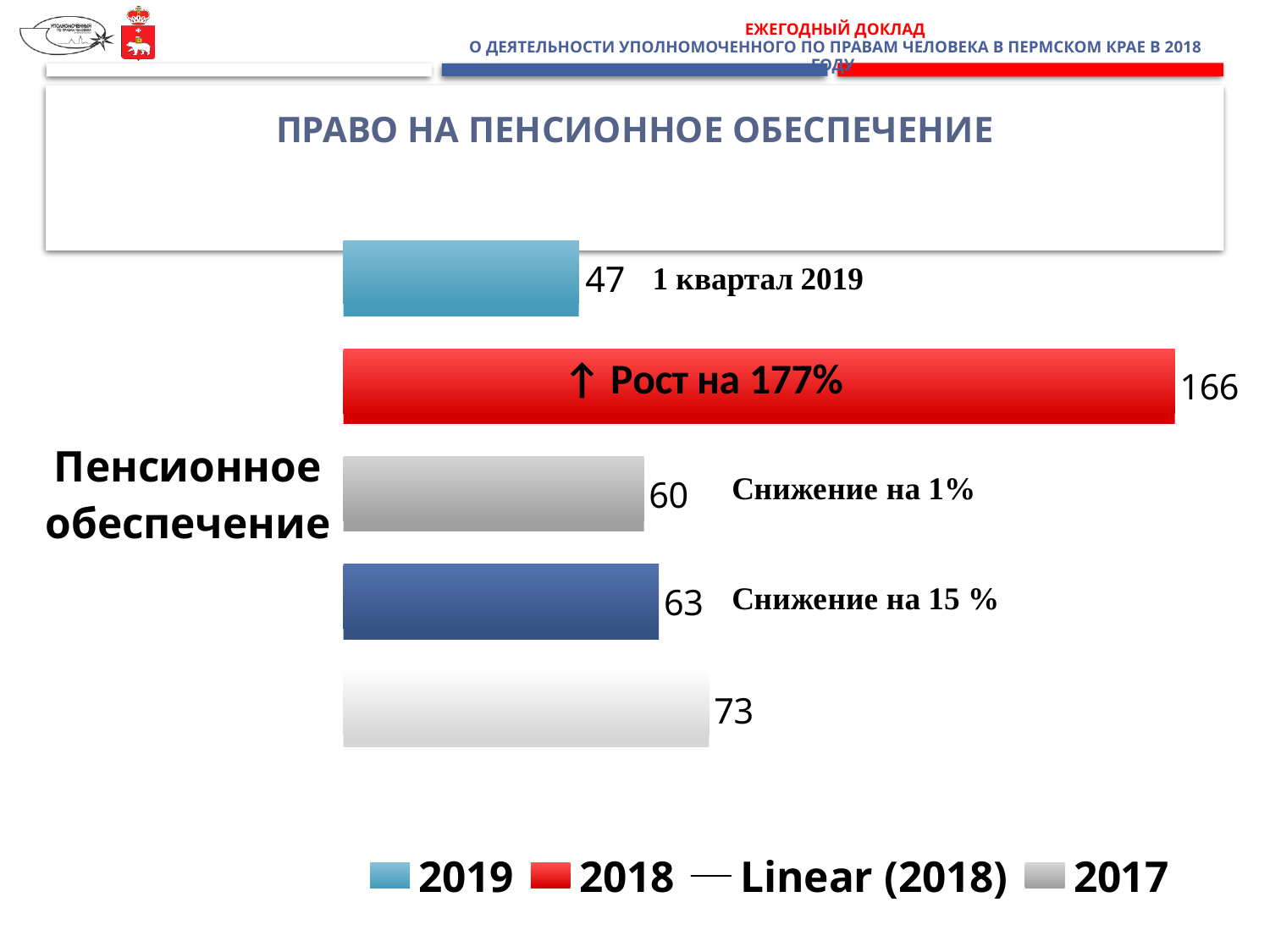
What category label is shown to the left of the bars? Пенсионное обеспечение What is the difference between the 2018 value and the 2019 value? 119 Which legend series has the highest value in the chart? 2018 Which is larger, the 2017 value or the 2019 value? 2017 How many entries does the chart legend list? 4 How many bars are plotted in the chart? 5 What is the difference between the 2018 value and the 2017 value? 106 What is the value of the 2018 bar in the chart? 166 What kind of chart is shown on the slide? bar chart What is the value of the 2019 bar in the chart? 47 Which legend series has the lowest value in the chart? 2019 What is the value of the 2017 bar in the chart? 60